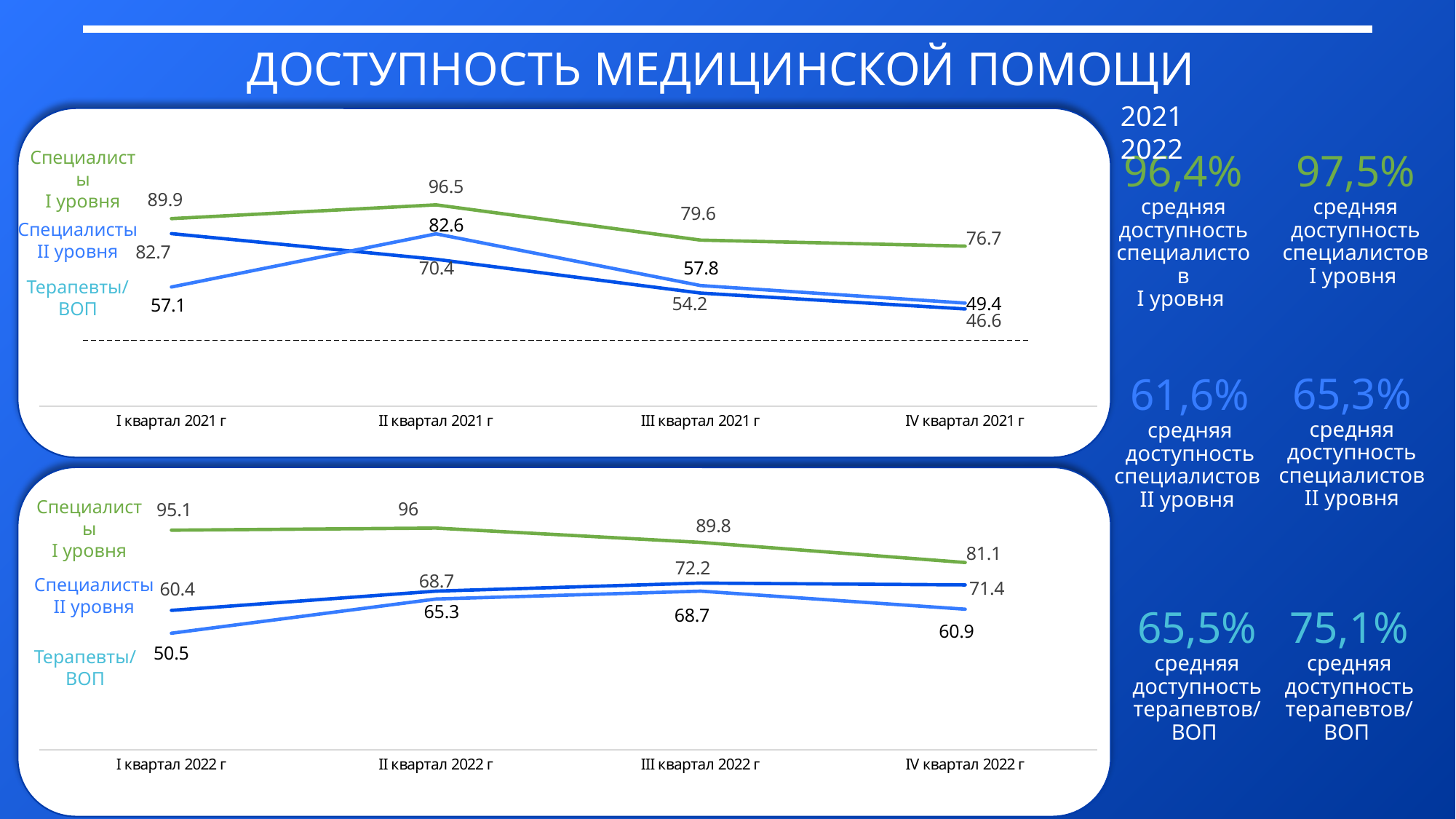
In the top chart (2021), what is the difference between Специалисты I уровня and Специалисты II уровня in IV квартал 2021 г? 30.1 In the top chart (2021), what is the value for Специалисты II уровня in IV квартал 2021 г? 46.6 In the bottom chart (2022), what is the value for Специалисты II уровня in III квартал 2022 г? 72.2 In the bottom chart (2022), in which quarter is the value for Специалисты I уровня highest? II квартал 2022 г In the top chart (2021), what is the value for Специалисты I уровня in II квартал 2021 г? 96.5 In the top chart (2021), which is larger in II квартал 2021 г: Специалисты II уровня or Терапевты/ВОП? Терапевты/ВОП In the top chart (2021), what is the value for Терапевты/ВОП in I квартал 2021 г? 57.1 What type of chart is the top chart (2021)? Line chart In the bottom chart (2022), what is the difference between Специалисты I уровня in I квартал 2022 г and IV квартал 2022 г? 14 How many series does the bottom chart (2022) show? 3 In the top chart (2021), does the value for Специалисты II уровня rise or fall from I квартал 2021 г to IV квартал 2021 г? Fall In the bottom chart (2022), in which quarter is the value for Терапевты/ВОП lowest? I квартал 2022 г